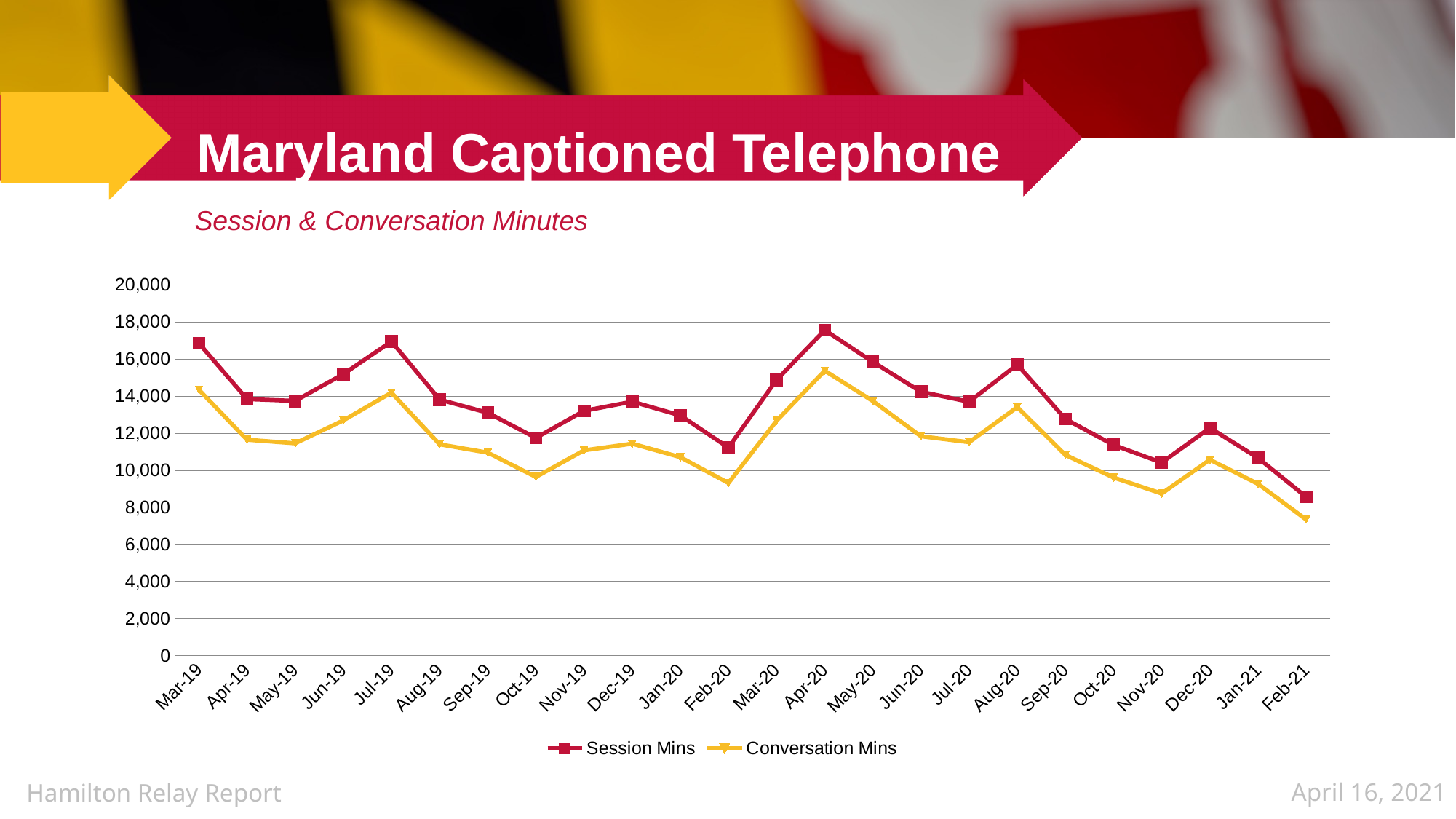
In which month is Session Mins at its highest? Apr-20 What colour is the Conversation Mins line? yellow Do the Session Mins values generally rise or fall from Aug-20 to Feb-21? fall In which month is Conversation Mins at its lowest? Feb-21 How many series does the legend list? 2 In which month is Session Mins at its lowest? Feb-21 What kind of chart is shown on the slide? line chart Is the value for Session Mins in Apr-20 greater or less than 16,000? greater Is the value for Conversation Mins in Feb-21 greater or less than 8,000? less How many months are plotted along the x axis? 24 Which is larger in Mar-19: Session Mins or Conversation Mins? Session Mins